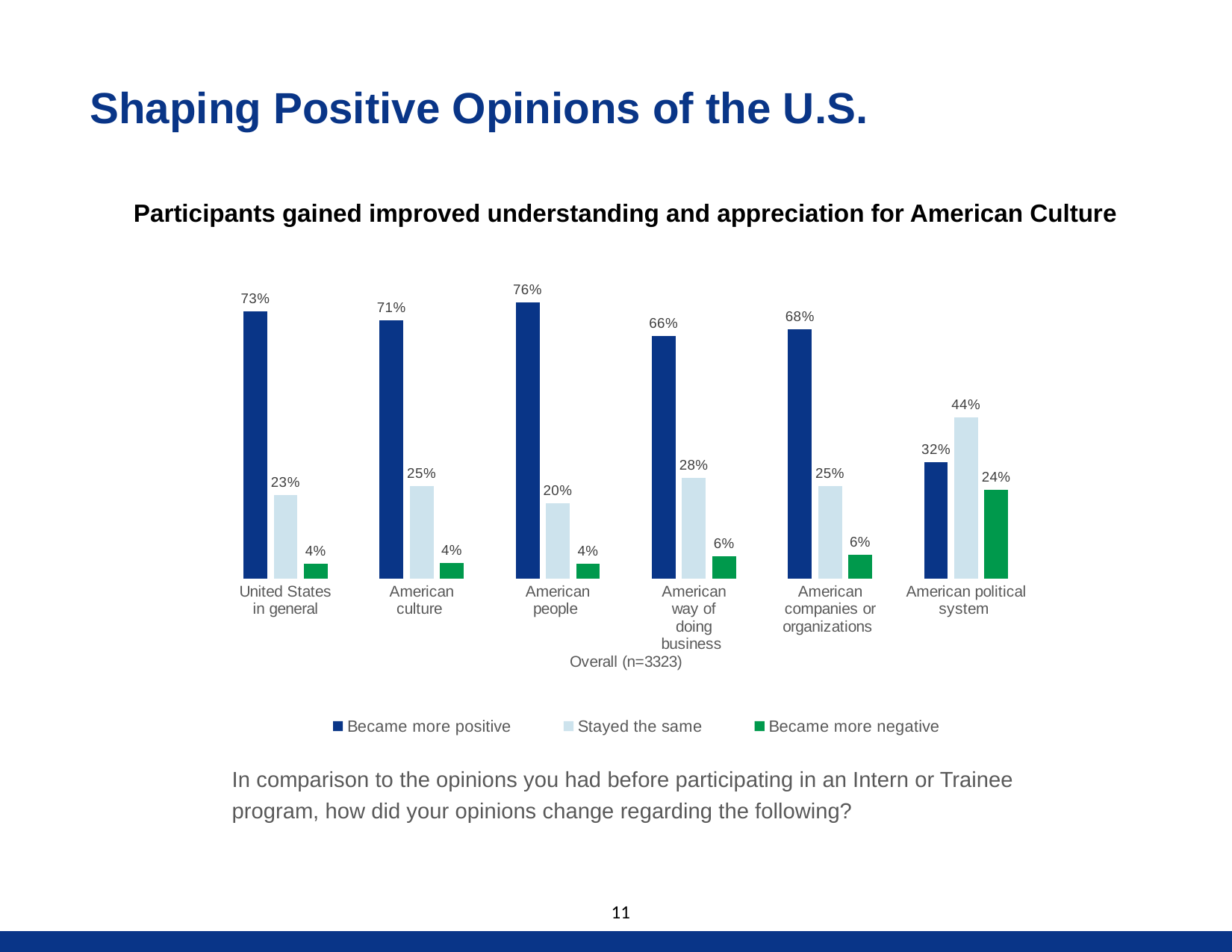
What is the sample size shown below the x axis? n=3323 Which category has the lowest 'Became more positive' value? American political system What kind of chart is shown on the slide? Bar chart How many categories are shown on the x axis? 6 Which category has the highest 'Became more positive' value? American people What percentage of participants became more negative about the American way of doing business? 6% What percentage of participants stayed the same regarding the American political system? 44% Which category has the highest 'Became more negative' value? American political system Which is larger: the 'Stayed the same' value for American culture or for American people? American culture What percentage of participants became more positive about American people? 76% How many series does the legend list? 3 What is the difference between the 'Became more positive' values for United States in general and American political system? 41 percentage points